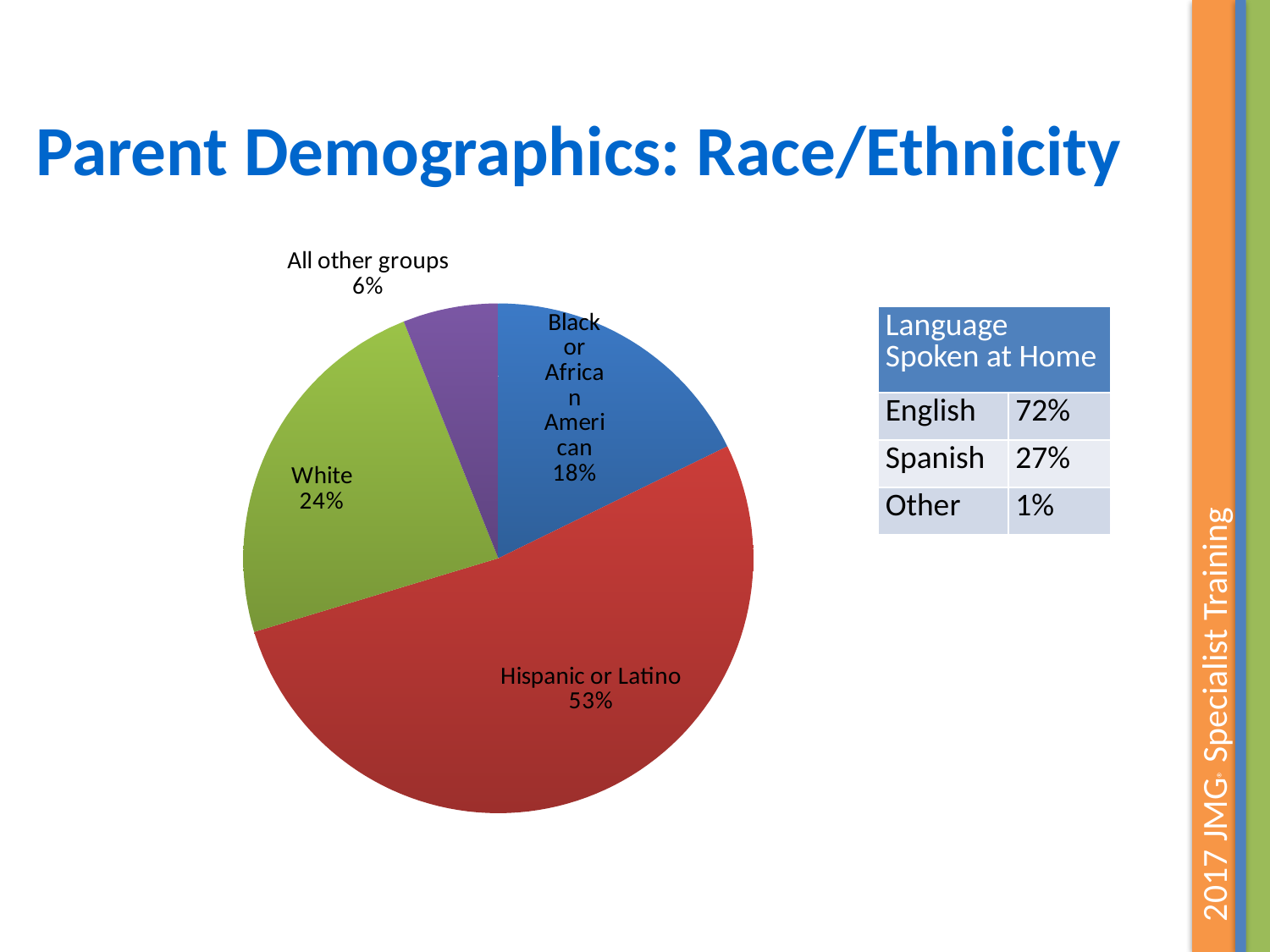
Which is larger in the pie chart, White or Black or African American? White What percentage does the pie chart show for Black or African American? 18% What percentage does the pie chart show for All other groups? 6% What is the difference in percentage points between Hispanic or Latino and White in the pie chart? 29 How many slices does the pie chart have? 4 Which group has the smallest slice of the pie chart? All other groups What colour is the Hispanic or Latino slice in the pie chart? red Which group has the largest slice of the pie chart? Hispanic or Latino What kind of chart is shown on the slide? pie chart What share of the pie chart is Hispanic or Latino? 53% What percentage does the pie chart show for White? 24% What is the difference in percentage points between White and All other groups in the pie chart? 18